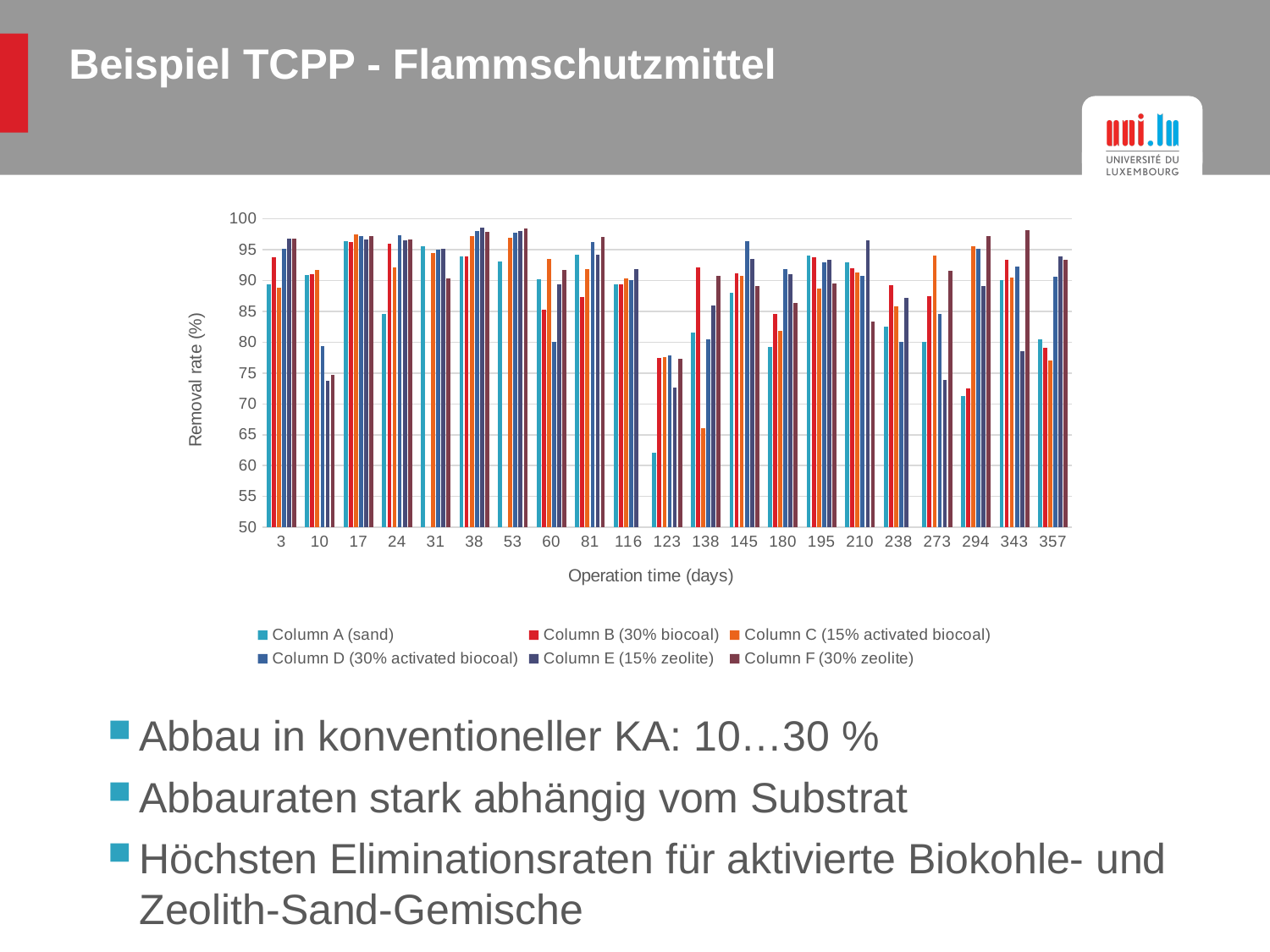
Is the value for Column D (30% activated biocoal) at day 17 greater or less than 95? greater How many series does the legend list? 6 Is the value for Column B (30% biocoal) at day 294 greater or less than 75? less What kind of chart is shown on the slide? bar chart What is the label of the y axis? Removal rate (%) Is the value for Column C (15% activated biocoal) at day 138 greater or less than 70? less What is the label of the x axis? Operation time (days) At day 123, which is larger: Column A (sand) or Column B (30% biocoal)? Column B (30% biocoal) How many operation-time categories are shown on the x axis? 21 At day 138, which is larger: Column B (30% biocoal) or Column C (15% activated biocoal)? Column B (30% biocoal)